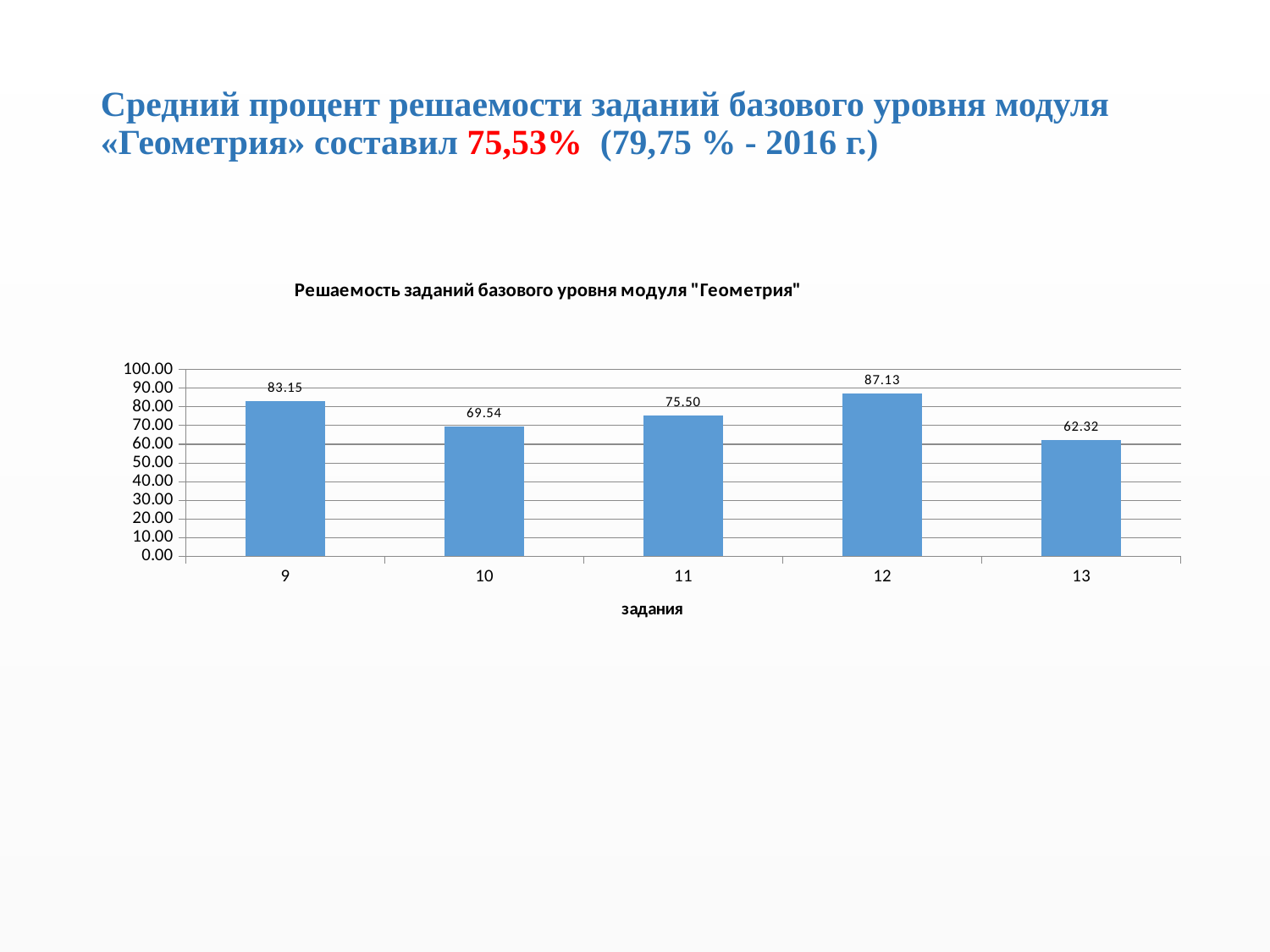
Which is larger, the value for task 9 or the value for task 11? 9 What is the label of the x axis? задания Which task has the lowest value? 13 Which task has the highest value? 12 What is the value for task 10? 69.54 How many tasks are shown on the x axis? 5 What kind of chart is this? bar chart What is the difference between the values for task 12 and task 13? 24.81 Is the value for task 11 greater or less than 70.00? greater What is the title of the chart? Решаемость заданий базового уровня модуля "Геометрия" What is the value for task 9? 83.15 What is the value for task 13? 62.32